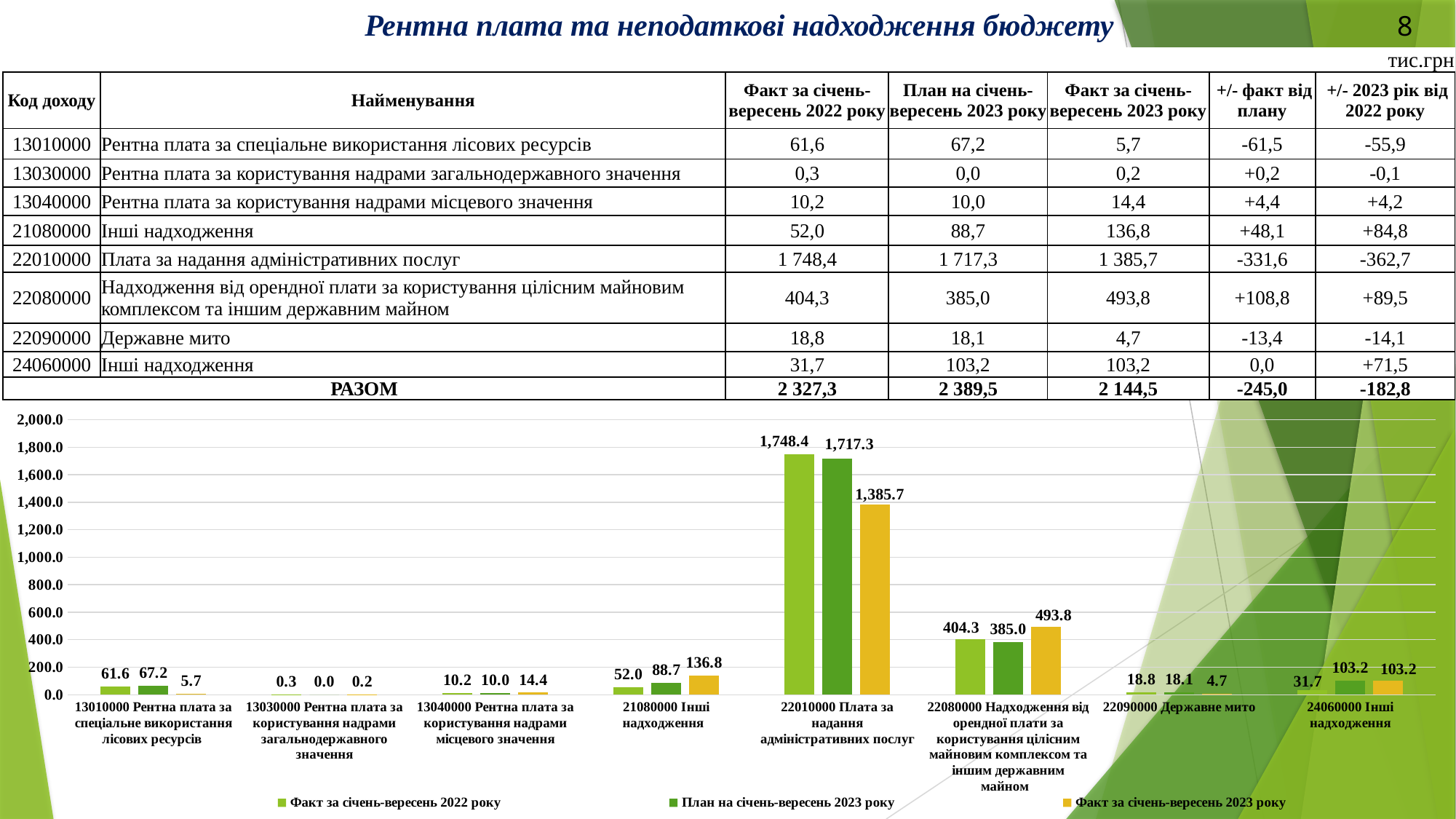
In the bar chart, what is the value of 'Факт за січень-вересень 2022 року' for '22090000 Державне мито'? 18.8 In the bar chart, which category has the highest value for 'Факт за січень-вересень 2022 року'? 22010000 Плата за надання адміністративних послуг How many series does the legend of the bar chart list? 3 In the bar chart, for '24060000 Інші надходження', which is larger: 'Факт за січень-вересень 2022 року' or 'Факт за січень-вересень 2023 року'? Факт за січень-вересень 2023 року In the bar chart, what is the value of 'План на січень-вересень 2023 року' for '21080000 Інші надходження'? 88.7 In the bar chart, is the value of 'Факт за січень-вересень 2022 року' for '22010000 Плата за надання адміністративних послуг' greater or less than 1,600.0? greater In the bar chart, what is the difference between 'Факт за січень-вересень 2022 року' and 'Факт за січень-вересень 2023 року' for '13010000 Рентна плата за спеціальне використання лісових ресурсів'? 55.9 In the bar chart, what is the difference between 'Факт за січень-вересень 2023 року' and 'План на січень-вересень 2023 року' for '22080000 Надходження від орендної плати за користування цілісним майновим комплексом та іншим державним майном'? 108.8 What type of chart is shown on the slide? bar chart How many categories are shown on the x axis of the bar chart? 8 In the bar chart, what is the value of 'Факт за січень-вересень 2023 року' for '22010000 Плата за надання адміністративних послуг'? 1,385.7 In the bar chart, which category has the lowest value for 'Факт за січень-вересень 2023 року'? 13030000 Рентна плата за користування надрами загальнодержавного значення